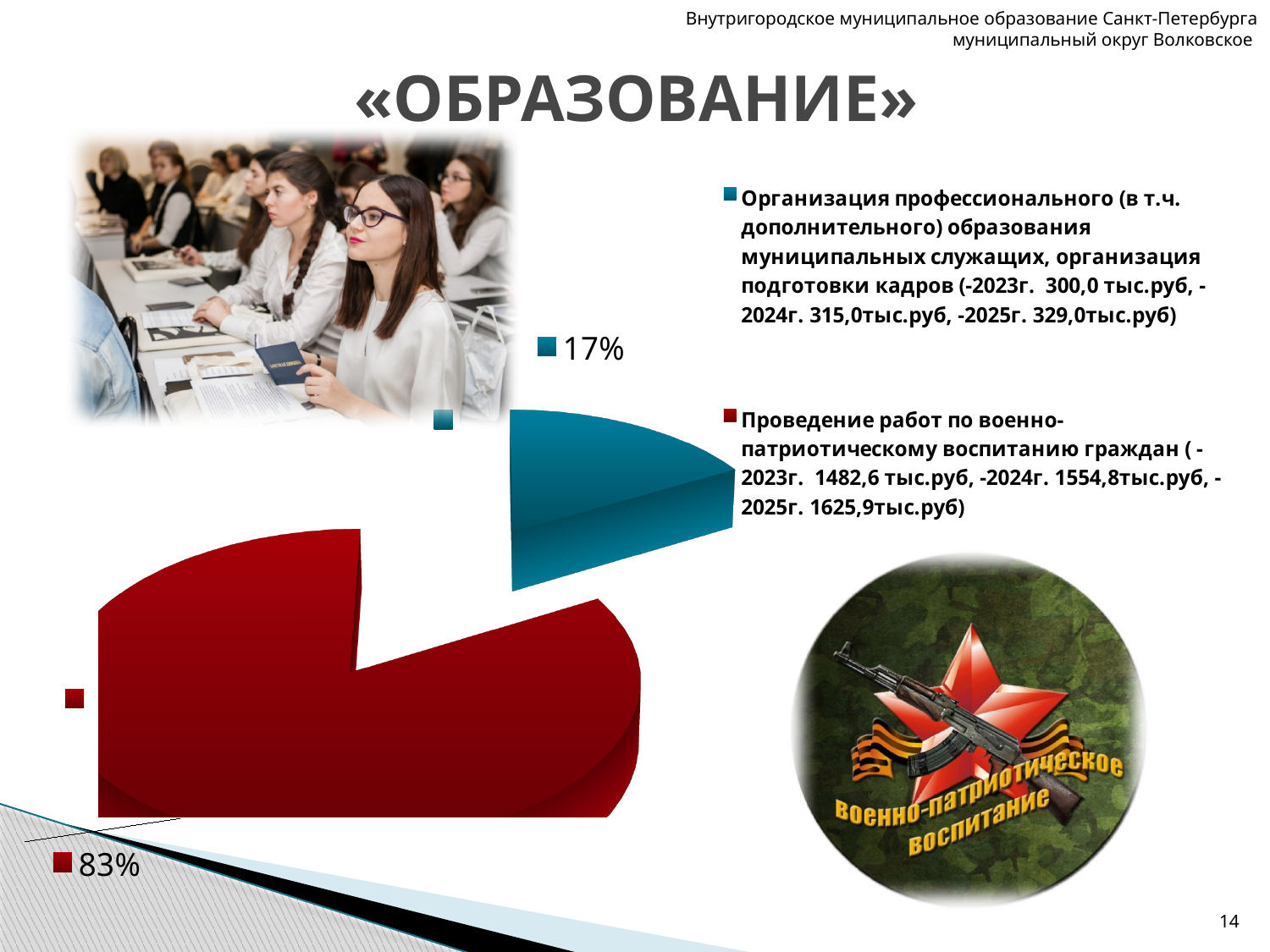
What share of the pie does the red slice (Проведение работ по военно-патриотическому воспитанию граждан) represent? 83% What is the difference in percentage points between the red slice and the blue slice? 66 What colour is the slice labelled 17%? blue Which slice of the pie chart is the largest? Проведение работ по военно-патриотическому воспитанию граждан (83%) Which slice of the pie chart is the smallest? Организация профессионального (в т.ч. дополнительного) образования муниципальных служащих (17%) What colour is the slice labelled 83%? red How many slices does the pie chart have? 2 How many entries does the legend of the pie chart list? 2 What kind of chart is shown on the slide? pie chart What share of the pie does the blue slice (Организация профессионального образования муниципальных служащих) represent? 17% Which is larger: the share for военно-патриотическое воспитание or the share for профессиональное образование муниципальных служащих? военно-патриотическое воспитание Is the share of the blue slice greater or less than 50%? less